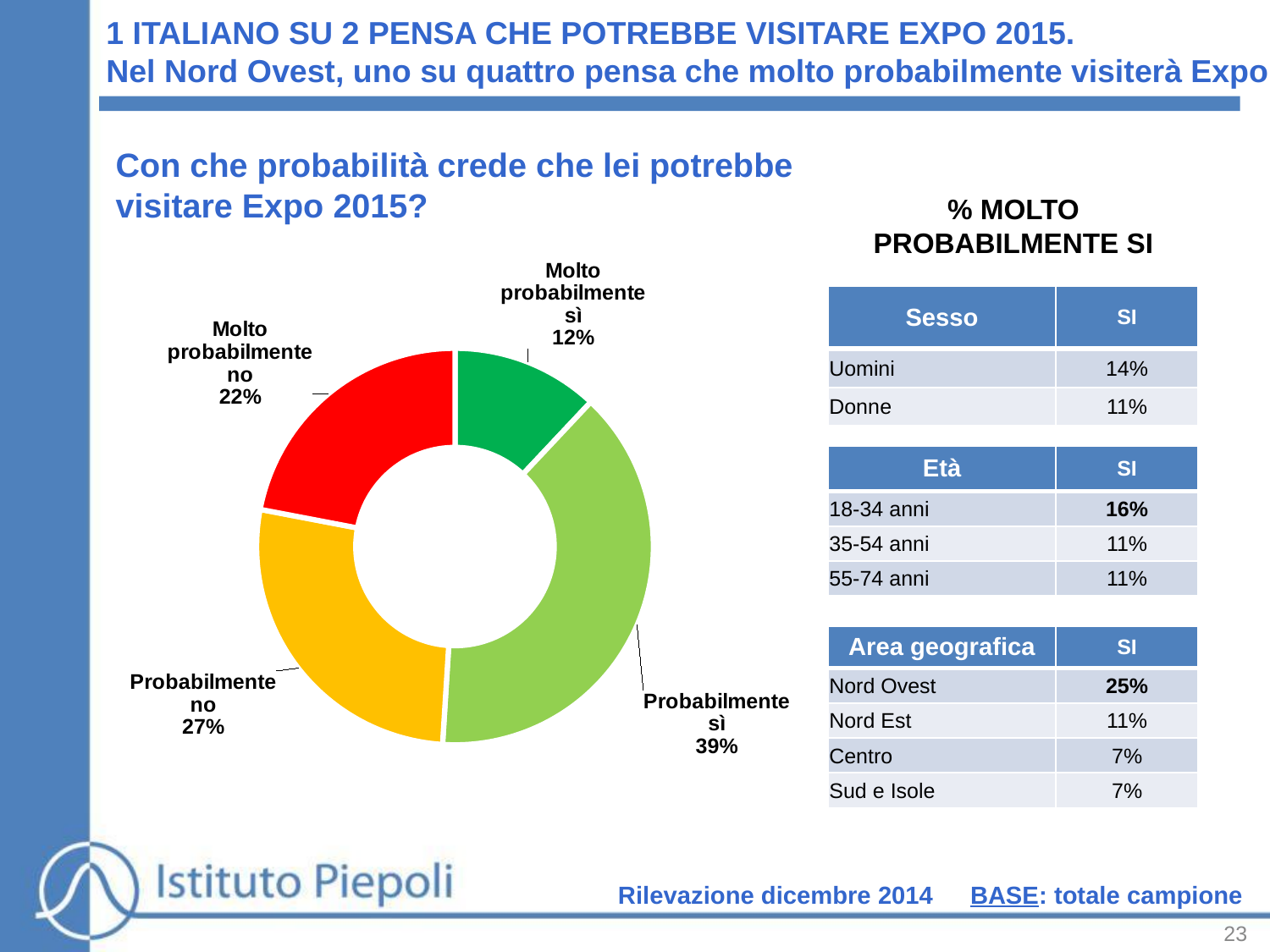
How many response categories are shown in the chart? 4 What is the difference in percentage points between 'Probabilmente sì' and 'Probabilmente no'? 12 Which response category has the smallest share of the chart? Molto probabilmente sì What percentage of respondents answered 'Molto probabilmente sì'? 12% What percentage of respondents answered 'Molto probabilmente no'? 22% What is the combined share of 'Molto probabilmente sì' and 'Probabilmente sì'? 51% What kind of chart is shown on the slide? Doughnut (pie) chart Which response category has the largest share of the chart? Probabilmente sì What colour is the 'Molto probabilmente no' slice? Red What percentage of respondents answered 'Probabilmente no'? 27% What percentage of respondents answered 'Probabilmente sì'? 39% Which is larger: the share for 'Molto probabilmente no' or the share for 'Probabilmente no'? Probabilmente no